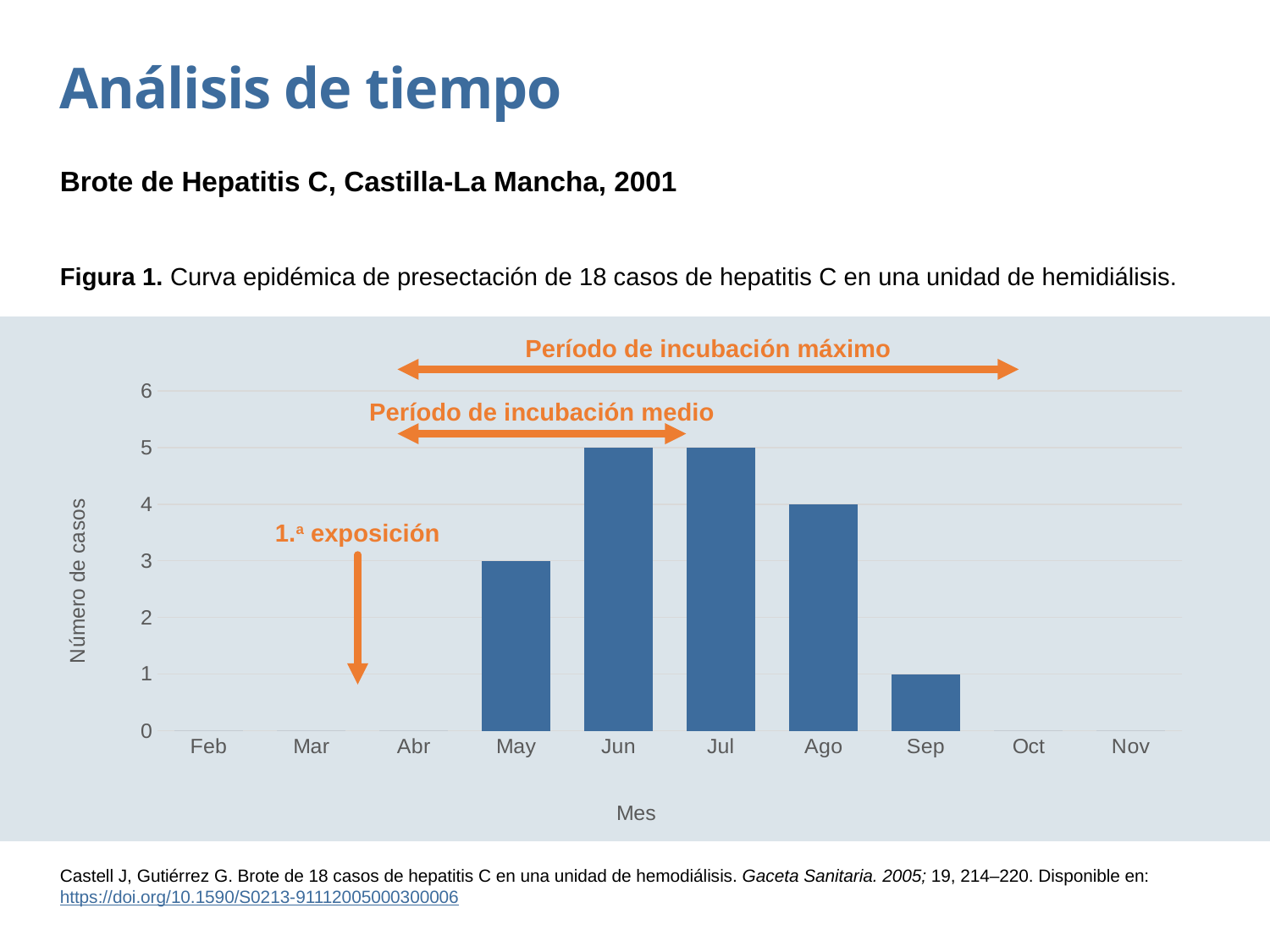
What is the total number of cases across all months shown? 18 What is the number of cases for Ago? 4 Which month has more cases, Ago or Sep? Ago What is the label of the y axis? Número de casos How many months are shown on the x axis? 10 What kind of chart is shown on the slide? Bar chart What is the number of cases for Jun? 5 Do the values rise or fall from Jul to Sep? Fall What is the difference in cases between Jun and May? 2 Is the value for Ago greater or less than 3? greater What is the number of cases for Sep? 1 How many cases are shown for May? 3